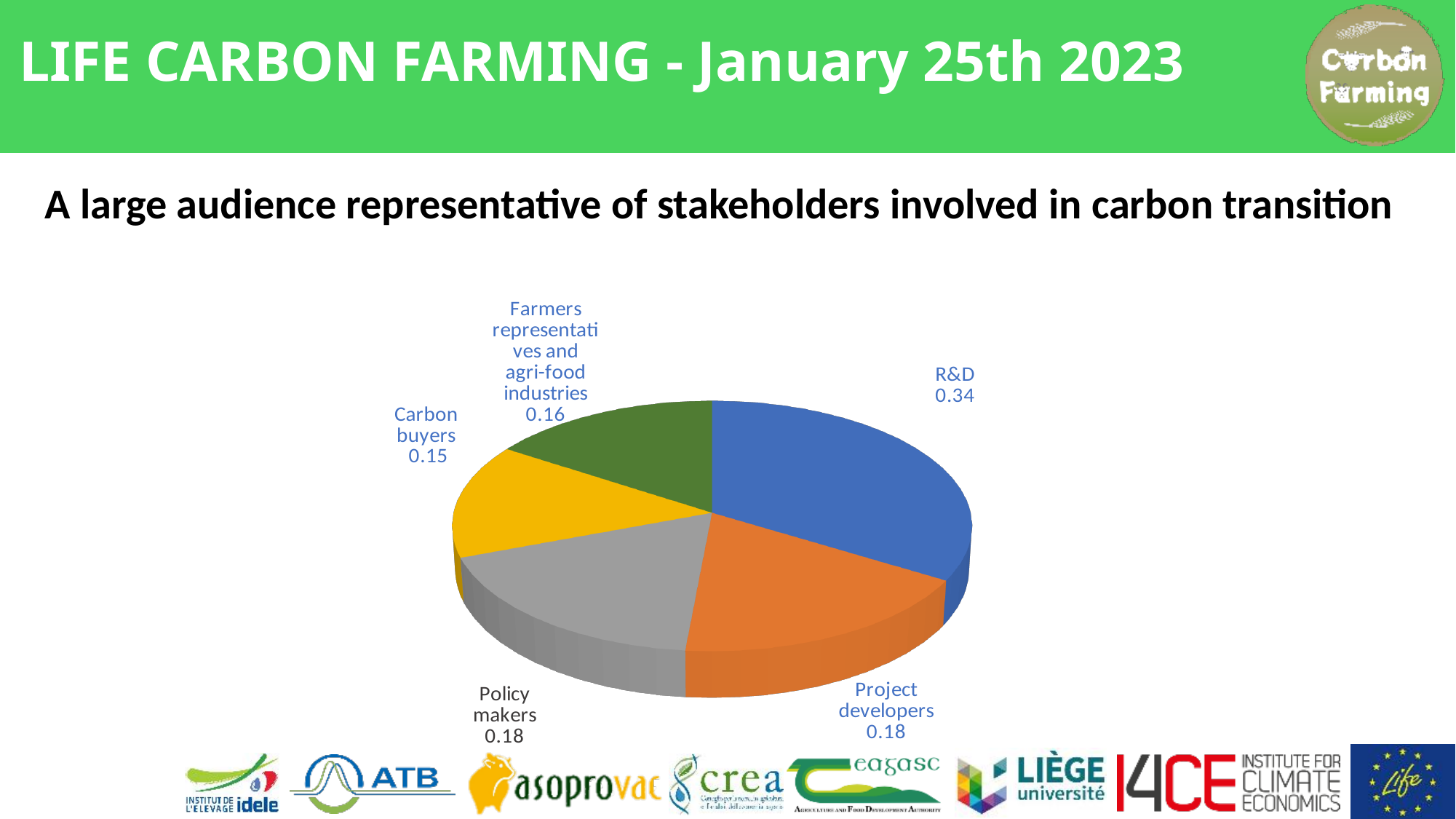
Which is larger, the value for R&D or the value for Project developers? R&D What is the value for R&D in the pie chart? 0.34 What is the value for Farmers representatives and agri-food industries in the pie chart? 0.16 What is the value for Project developers in the pie chart? 0.18 What kind of chart is shown on the slide? Pie chart Which category has the smallest slice of the pie chart? Carbon buyers What is the value for Carbon buyers in the pie chart? 0.15 Which category has the largest slice of the pie chart? R&D What is the difference between the values for R&D and Policy makers? 0.16 What is the value for Policy makers in the pie chart? 0.18 How many slices does the pie chart have? 5 What colour is the R&D slice in the pie chart? Blue